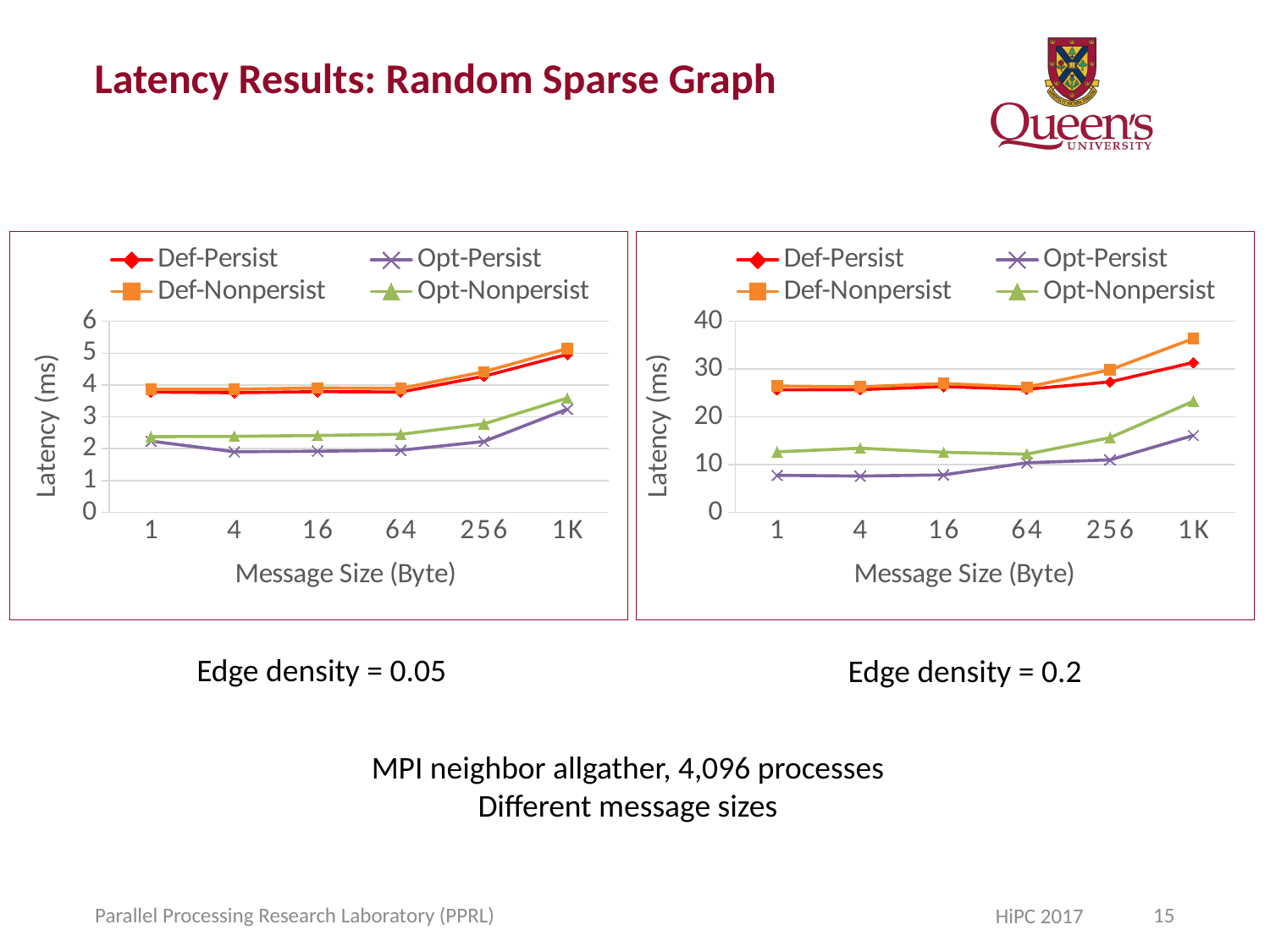
In the right chart (Edge density = 0.2), does the Def-Nonpersist latency rise or fall from message size 64 to 1K? rise In the right chart (Edge density = 0.2), at message size 1K, which has the higher latency: Opt-Nonpersist or Opt-Persist? Opt-Nonpersist How many series does the legend of the right chart (Edge density = 0.2) list? 4 In the right chart (Edge density = 0.2), which series has the highest latency at message size 1K? Def-Nonpersist In the left chart (Edge density = 0.05), is the latency for Def-Persist at message size 1 greater or less than 3? greater What kind of chart is the left chart (Edge density = 0.05)? line chart In the right chart (Edge density = 0.2), is the latency for Opt-Persist at message size 1 greater or less than 10? less How many message sizes are plotted along the x axis of the left chart (Edge density = 0.05)? 6 What is the y-axis title of the left chart (Edge density = 0.05)? Latency (ms) In the left chart (Edge density = 0.05), is the latency for Opt-Nonpersist at message size 1 greater or less than 3? less In the left chart (Edge density = 0.05), which series has the lowest latency at message size 64? Opt-Persist